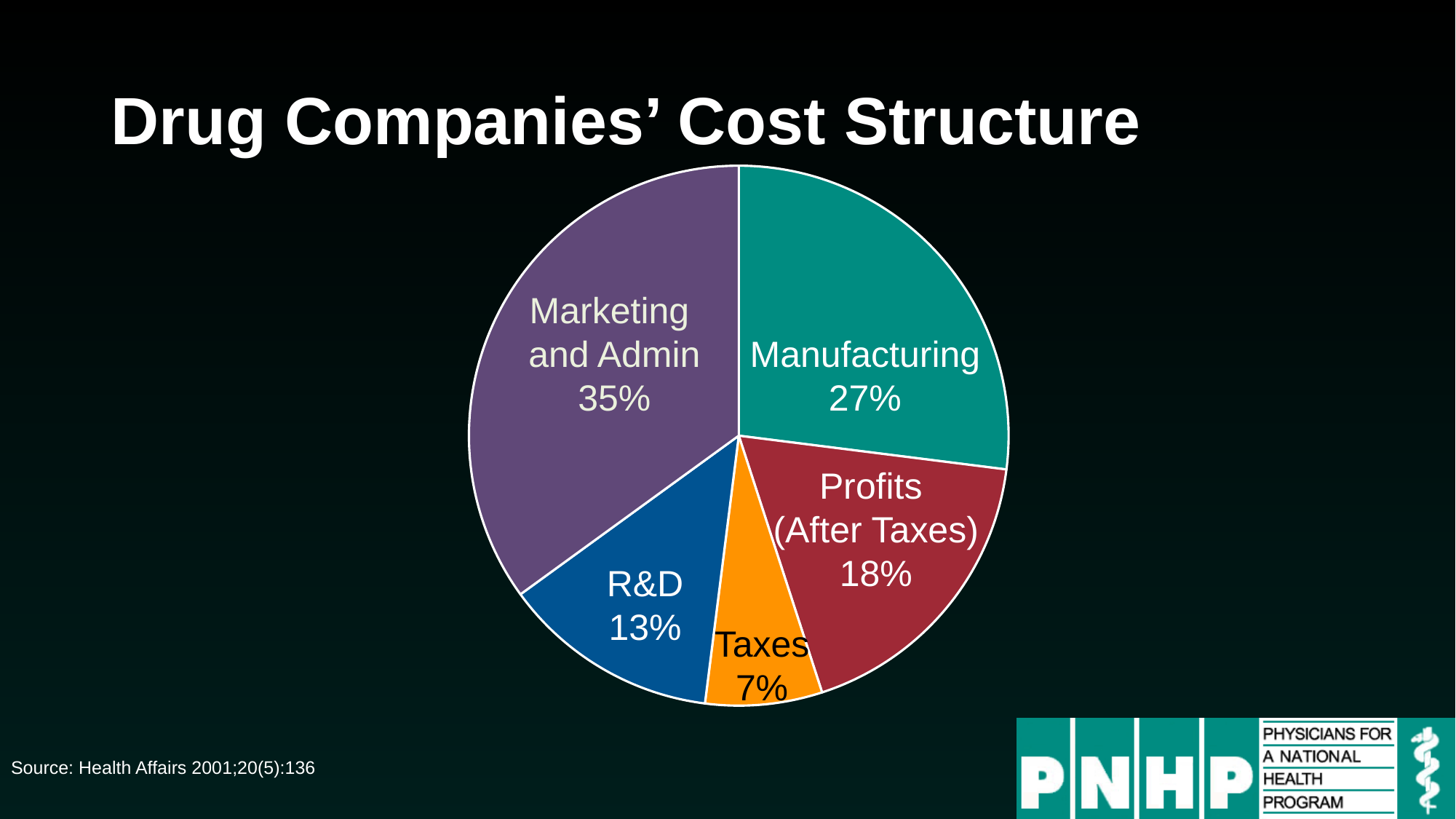
How many percentage points larger is Marketing and Admin than R&D? 22 What is the title of the chart? Drug Companies' Cost Structure What percentage is shown for Taxes? 7% What kind of chart is shown on the slide? Pie chart What is the value shown for Profits (After Taxes)? 18% Which category has the largest share of the pie? Marketing and Admin What percentage is shown for R&D? 13% How many slices does the pie chart have? 5 What percentage does the Manufacturing slice represent? 27% What share of drug companies' cost structure is Marketing and Admin? 35% Which category has the smallest share of the pie? Taxes Which is larger, Manufacturing or Profits (After Taxes)? Manufacturing